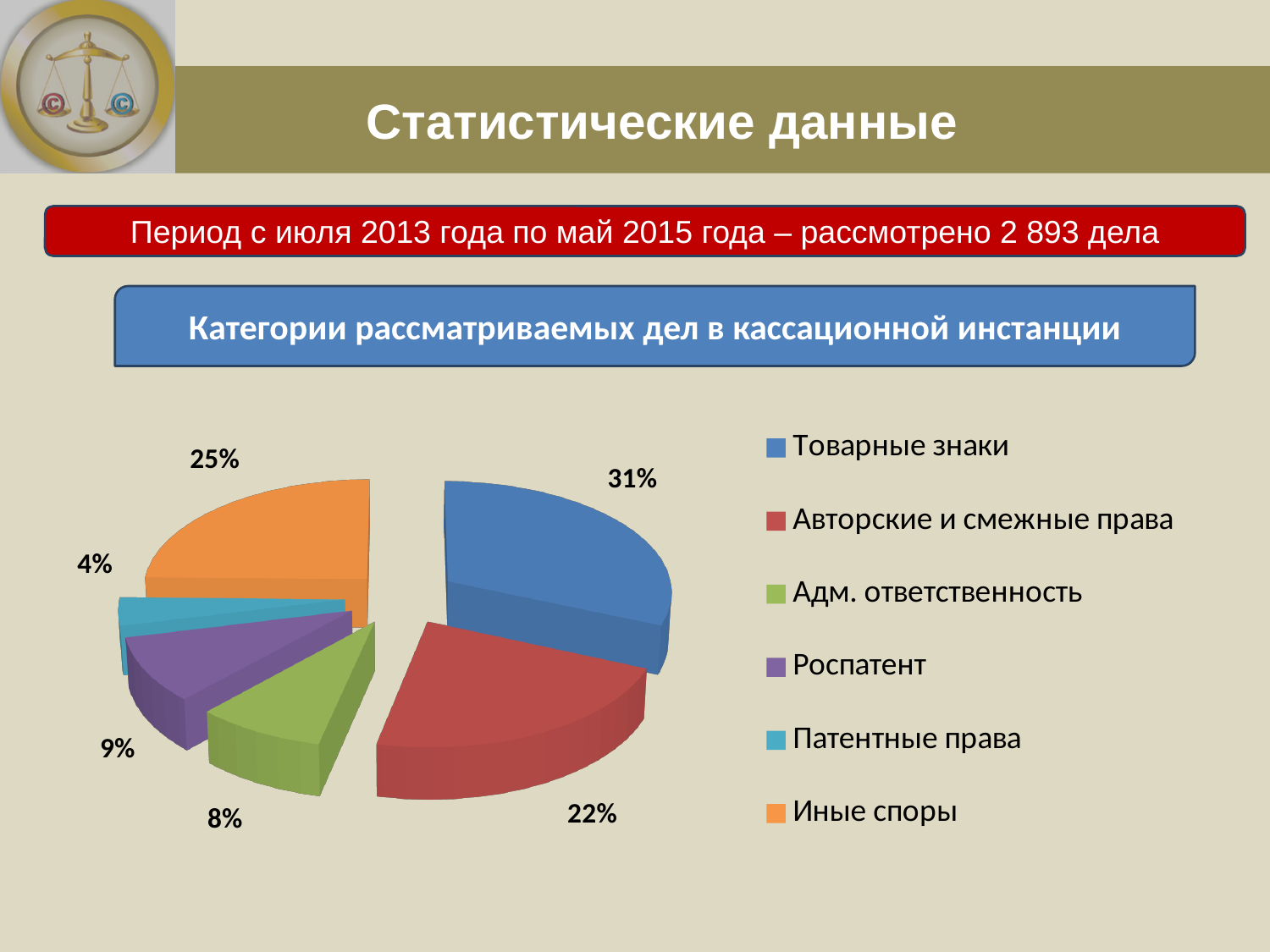
Which category has the smallest share of the pie? Патентные права What kind of chart is shown on the slide? pie chart What share of the pie does Авторские и смежные права have? 22% What is the difference in percentage points between Товарные знаки and Авторские и смежные права? 9 Which category has the largest share of the pie? Товарные знаки How many categories does the legend list? 6 What share of the pie does Товарные знаки have? 31% What share of the pie does Патентные права have? 4% What colour is the slice for Иные споры? orange Which is larger, the share for Роспатент or the share for Адм. ответственность? Роспатент